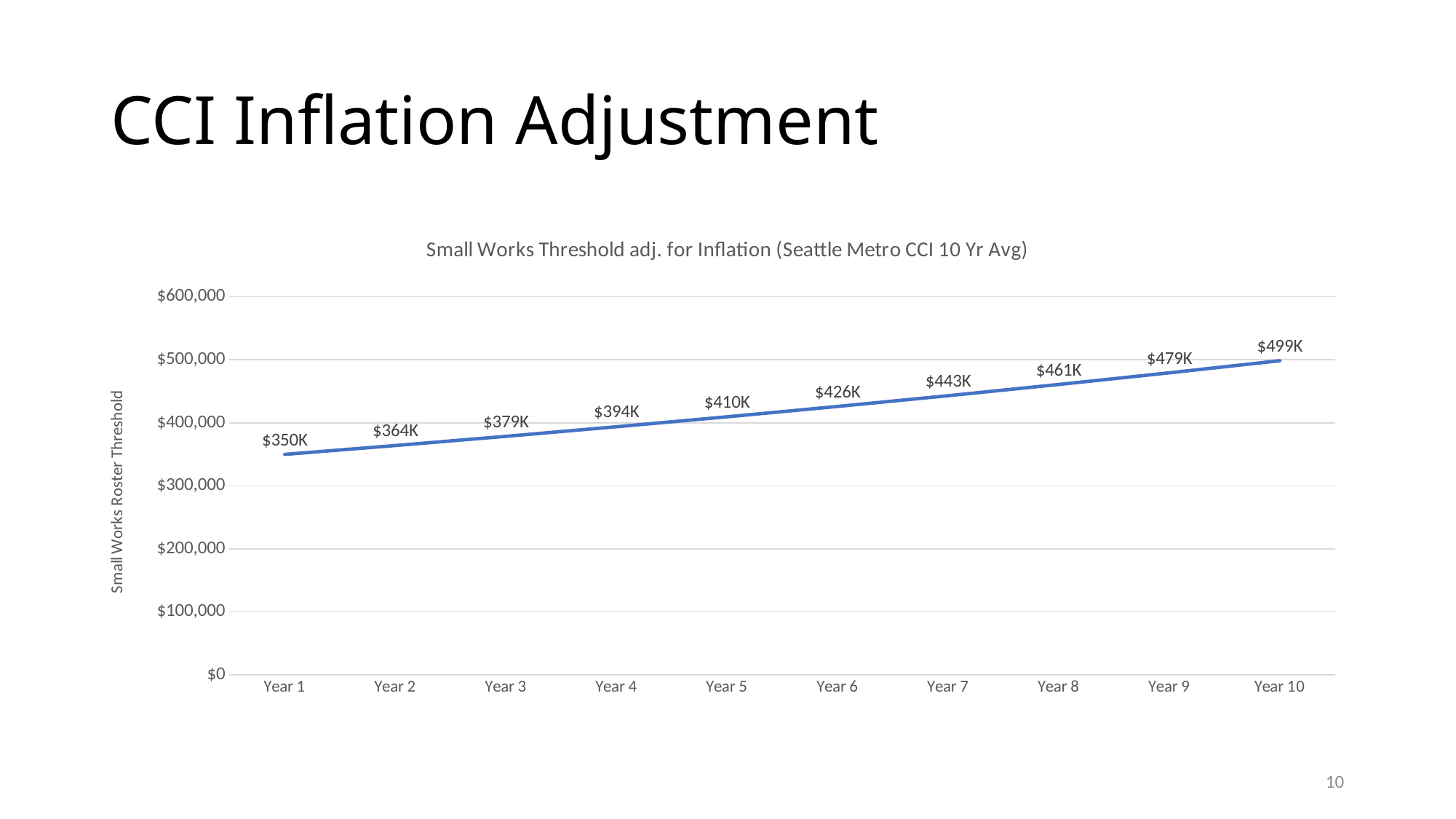
What is the value shown for Year 10? $499K What kind of chart is shown on the slide? Line chart Do the values rise or fall from Year 1 to Year 10? Rise Which is larger, the value for Year 7 or the value for Year 4? Year 7 Is the value for Year 8 greater or less than $400,000? greater What is the title of the chart? Small Works Threshold adj. for Inflation (Seattle Metro CCI 10 Yr Avg) How many years are plotted on the x axis? 10 What is the Small Works Roster Threshold value for Year 1? $350K What is the value shown for Year 5? $410K Which year has the highest threshold value? Year 10 Which year has the lowest threshold value? Year 1 What is the difference between the Year 10 value and the Year 1 value? $149K